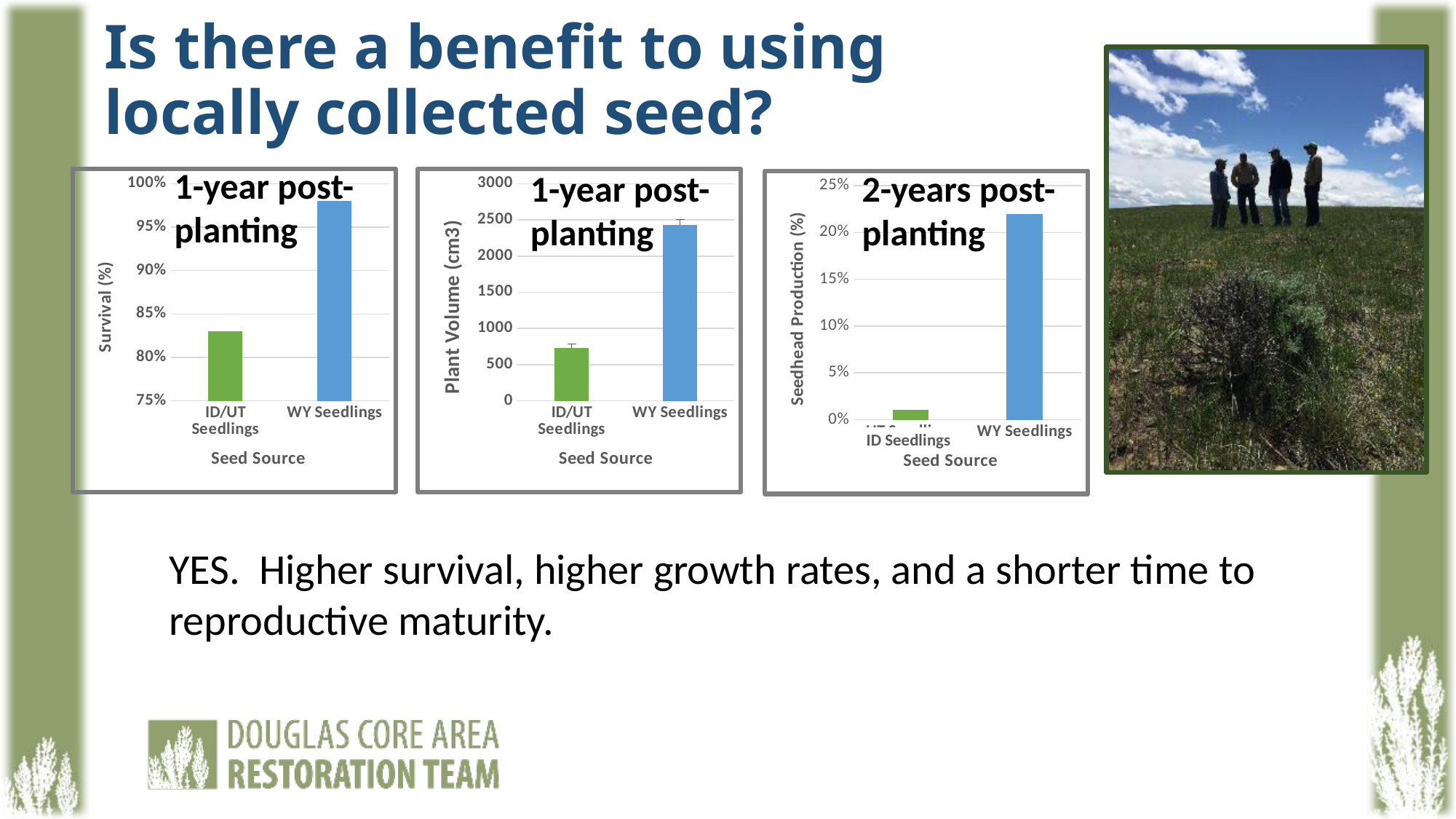
How many seed source categories are shown in the middle chart (Plant Volume (cm3))? 2 In the middle chart (Plant Volume (cm3)), is the value for WY Seedlings greater or less than 2000? greater In the right chart (Seedhead Production (%)), is the value for ID Seedlings greater or less than 5%? less What is the x-axis title of the right chart (Seedhead Production (%))? Seed Source In the right chart (Seedhead Production (%)), is the value for WY Seedlings greater or less than 20%? greater In the left chart (Survival (%)), which seed source has the higher survival? WY Seedlings In the middle chart (Plant Volume (cm3)), which seed source has the lower plant volume? ID/UT Seedlings In the right chart (Seedhead Production (%)), which seed source has the higher seedhead production? WY Seedlings What kind of chart is the left chart (Survival (%))? bar chart